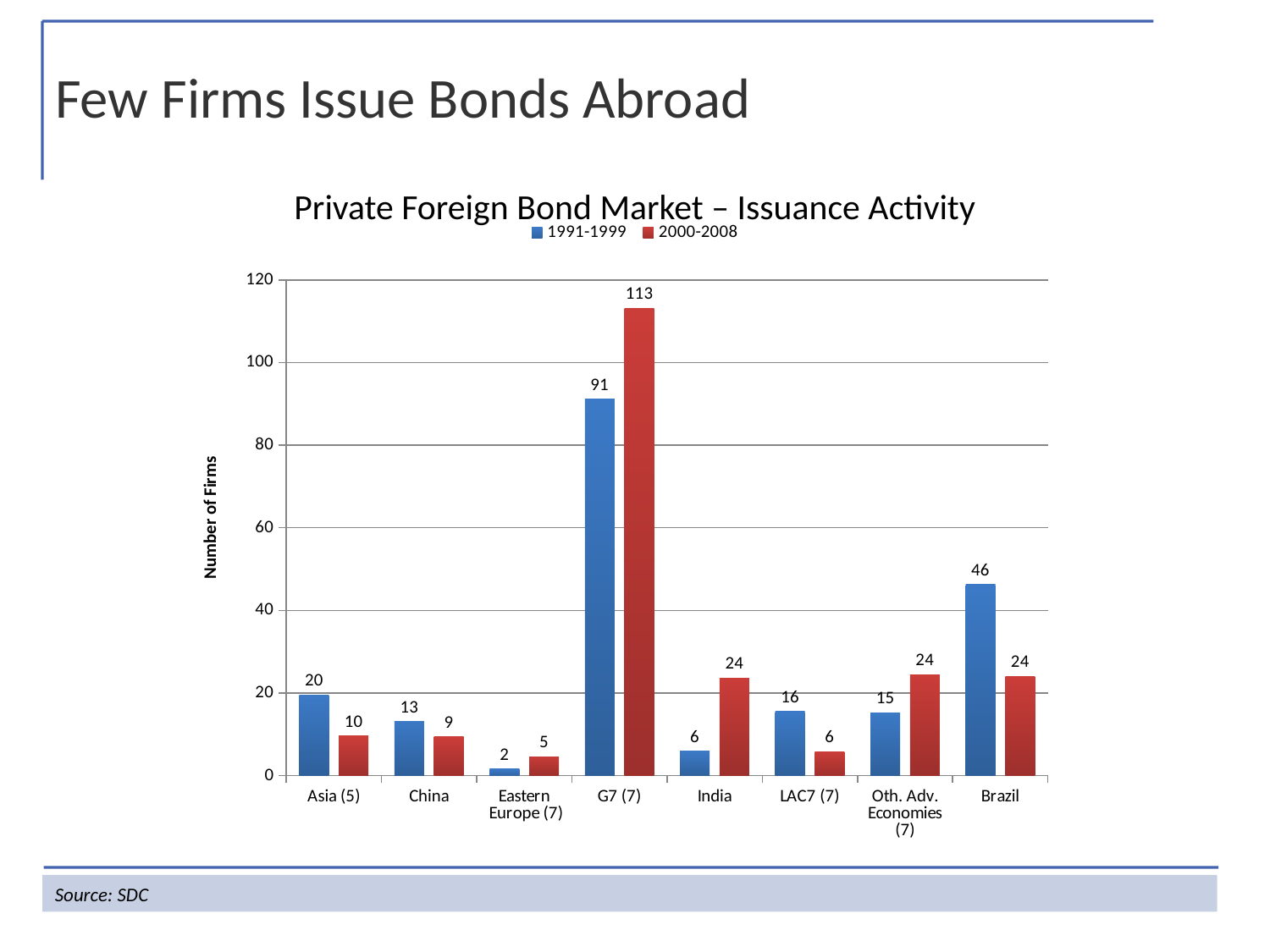
What is the value for Eastern Europe (7) in the 1991-1999 series? 2 What is the value for G7 (7) in the 2000-2008 series? 113 What is the value for Brazil in the 1991-1999 series? 46 How many series does the legend list? 2 Which is larger for India: the 1991-1999 value or the 2000-2008 value? 2000-2008 What is the difference between the 2000-2008 and 1991-1999 values for G7 (7)? 22 What kind of chart is shown on the slide? bar chart Is the 1991-1999 value for G7 (7) greater or less than 80? greater Which category has the highest value in the 2000-2008 series? G7 (7) How many categories are shown on the x axis? 8 What is the title of the chart? Private Foreign Bond Market – Issuance Activity Which category has the lowest value in the 1991-1999 series? Eastern Europe (7)